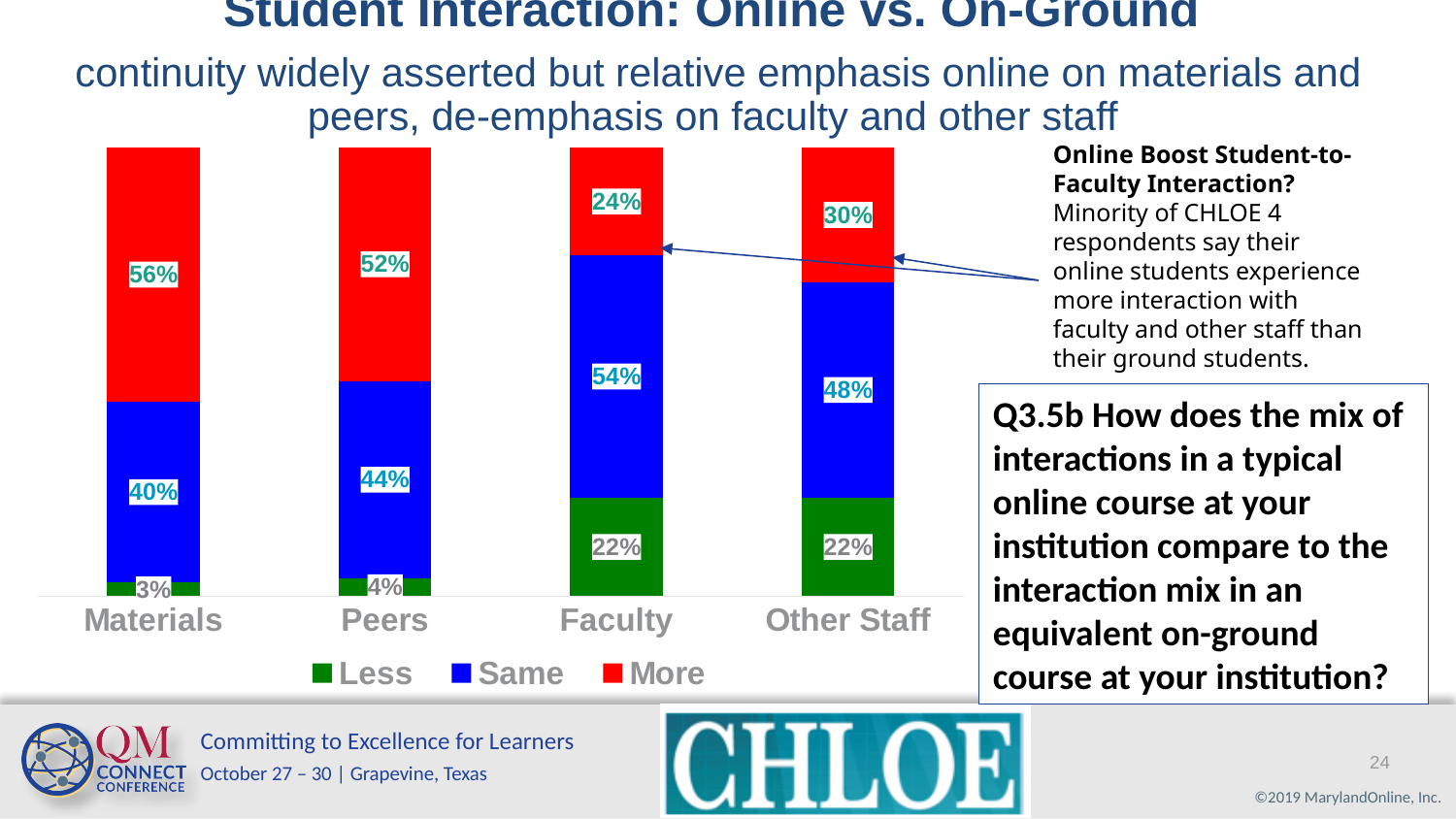
What is the 'Less' value for Other Staff? 22% How many categories are shown on the x axis of the chart? 4 Which colour represents the 'Same' series in the chart? Blue How many series does the chart's legend list? 3 What is the 'More' value for Materials? 56% What kind of chart is shown on the slide? Stacked bar chart Which category has the highest 'More' value? Materials What is the difference between the 'More' values for Materials and Faculty? 32% What is the 'Same' value for Faculty? 54% What is the 'More' value for Peers? 52% Which is larger, the 'Same' value for Faculty or the 'Same' value for Other Staff? Faculty Which category has the lowest 'Less' value? Materials